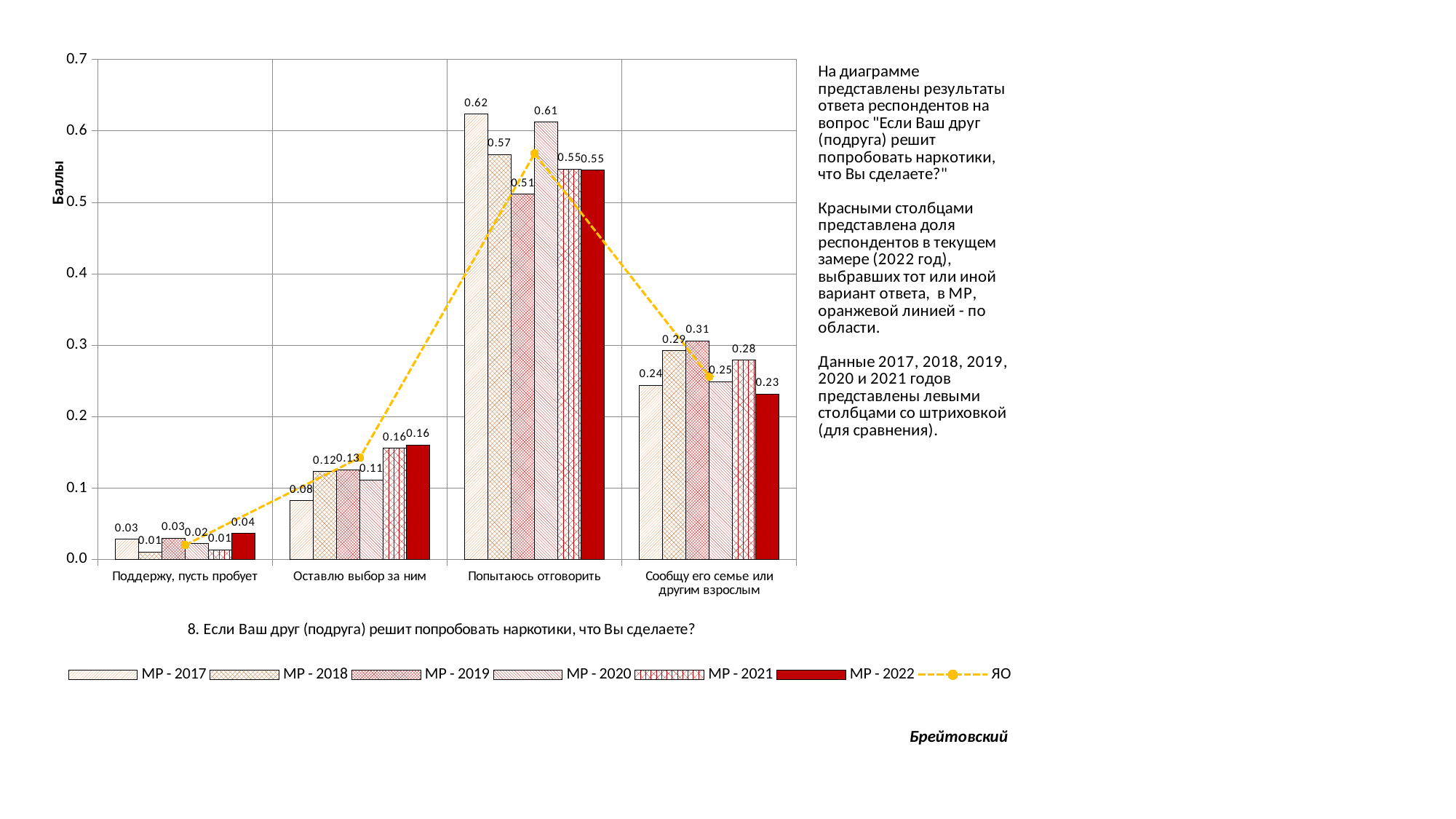
Which category has the lowest value for МР - 2022? Поддержу, пусть пробует Which category has the highest value for МР - 2022? Попытаюсь отговорить Is the value of the ЯО line for the category "Сообщу его семье или другим взрослым" greater or less than 0.3? less How many categories are shown on the x axis of the chart? 4 What is the difference between МР - 2017 and МР - 2022 for the category "Попытаюсь отговорить"? 0.07 What is the value of МР - 2022 for the category "Попытаюсь отговорить"? 0.55 What is the title of the vertical axis of the chart? Баллы How many series does the legend list? 7 What is the value of МР - 2021 for the category "Оставлю выбор за ним"? 0.16 For the category "Сообщу его семье или другим взрослым", which is larger: МР - 2019 or МР - 2022? МР - 2019 Is the value of the ЯО line for the category "Попытаюсь отговорить" greater or less than 0.5? greater What is the value of МР - 2017 for the category "Попытаюсь отговорить"? 0.62